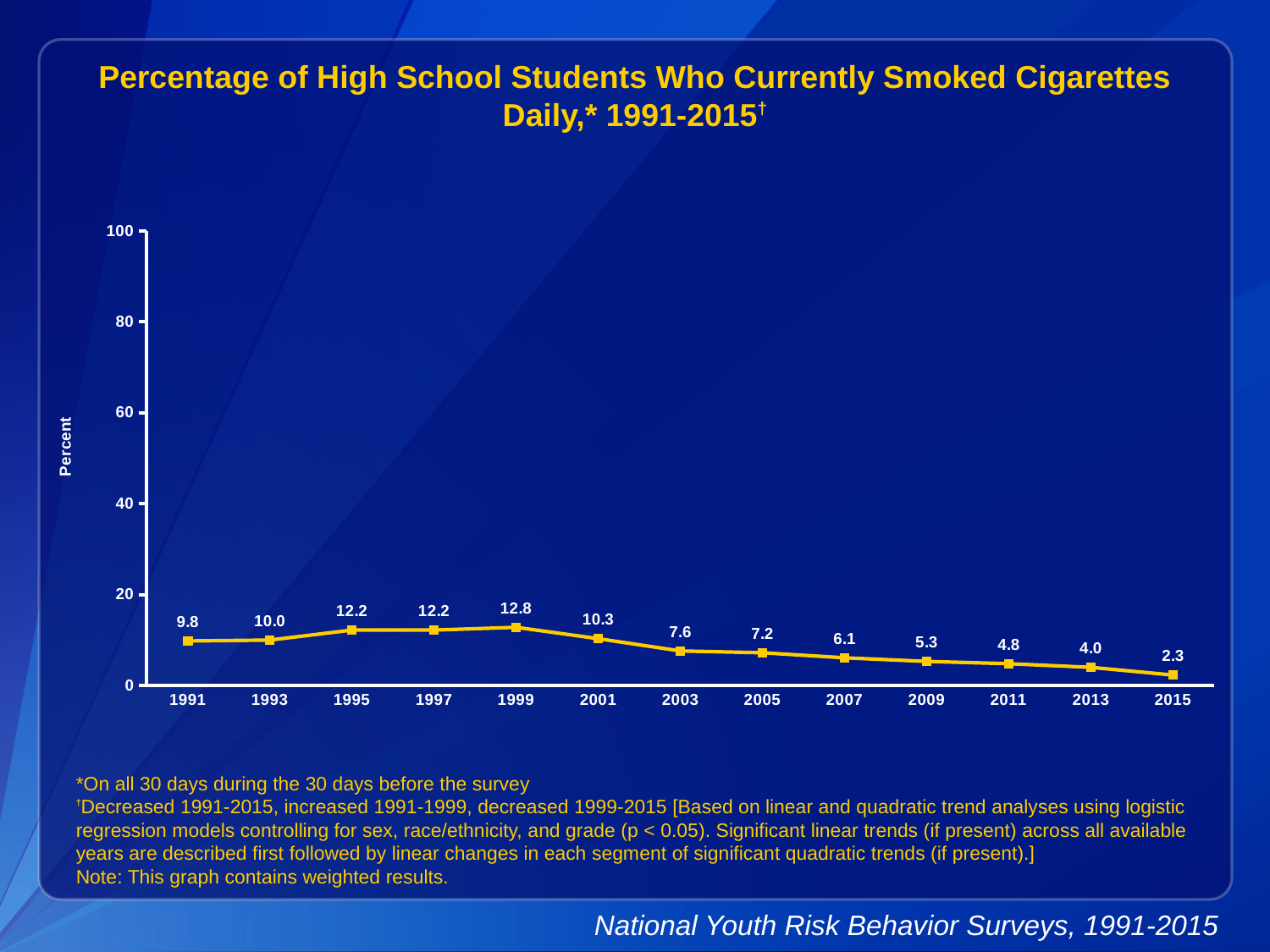
How many years are plotted on the chart? 13 Do the values rise or fall from 1999 to 2015? fall What value is shown for 2007? 6.1 Is the value for 1999 greater or less than 20? less What is the difference between the values for 1991 and 2001? 0.5 What value is shown for 2015? 2.3 What is the difference between the values for 1999 and 2015? 10.5 What was the percentage of high school students who currently smoked cigarettes daily in 1991? 9.8 Which year has a larger value, 2003 or 2009? 2003 Which year has the highest value on the chart? 1999 Which year has the lowest value on the chart? 2015 What kind of chart is shown on the slide? line chart